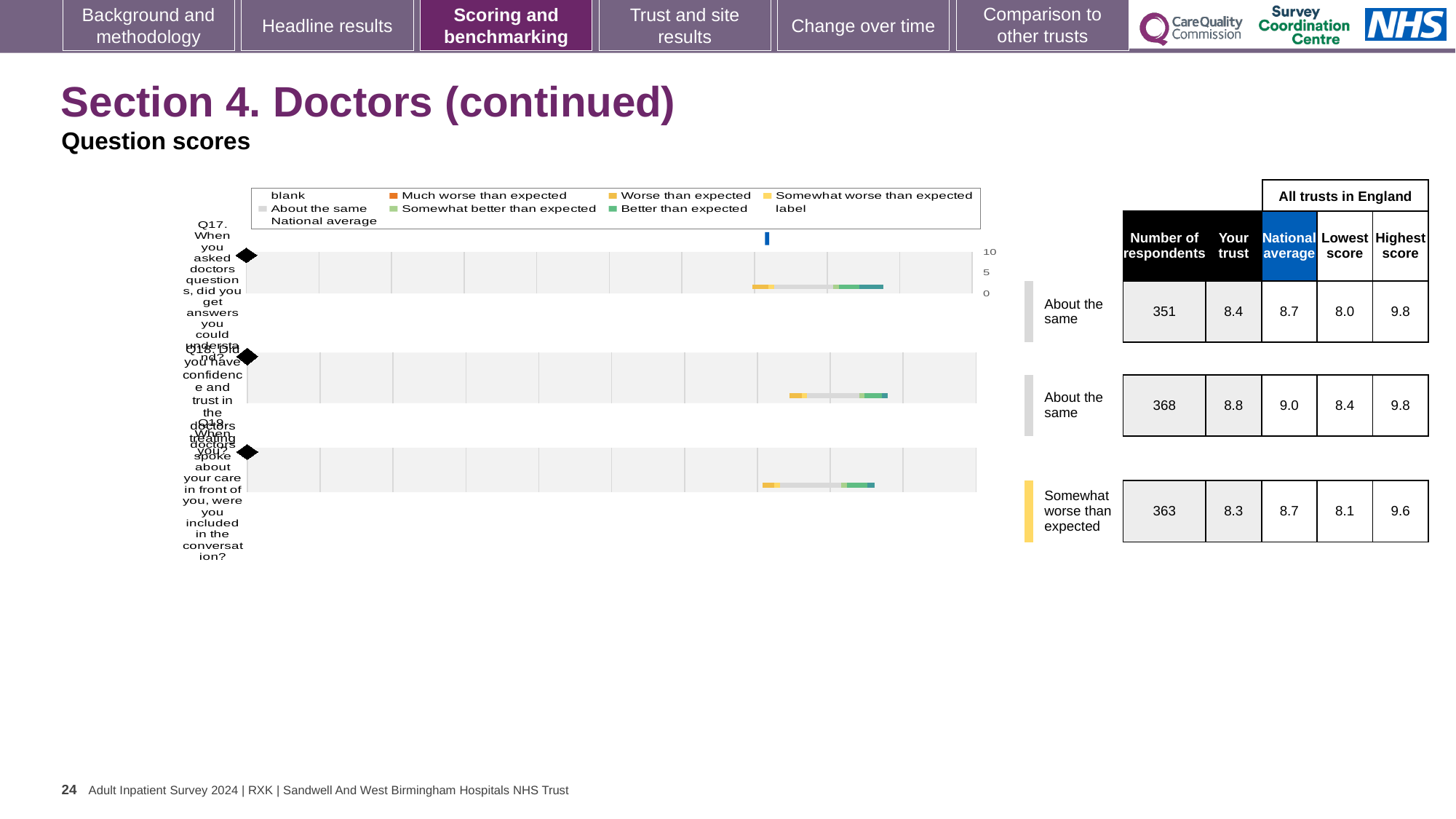
What kind of chart is used to show the question scores for Q17 to Q19? bar chart Which benchmark category is shown for Q19? Somewhat worse than expected For Q18, what is the difference between the national average and the 'Your trust' score? 0.2 How many questions are plotted in the chart? 3 What is the lowest score among all trusts in England for Q17? 8.0 What is the highest score among all trusts in England for Q19? 9.6 How many respondents answered Q19 (When doctors spoke about your care in front of you, were you included in the conversation)? 363 For Q17, which is larger: the 'Your trust' score or the national average? National average Which question has the highest 'Your trust' score? Q18 Which question has the lowest 'Your trust' score? Q19 What is the national average score for Q18 (Did you have confidence and trust in the doctors treating you)? 9.0 What is the 'Your trust' score for Q17 (When you asked doctors questions, did you get answers you could understand)? 8.4